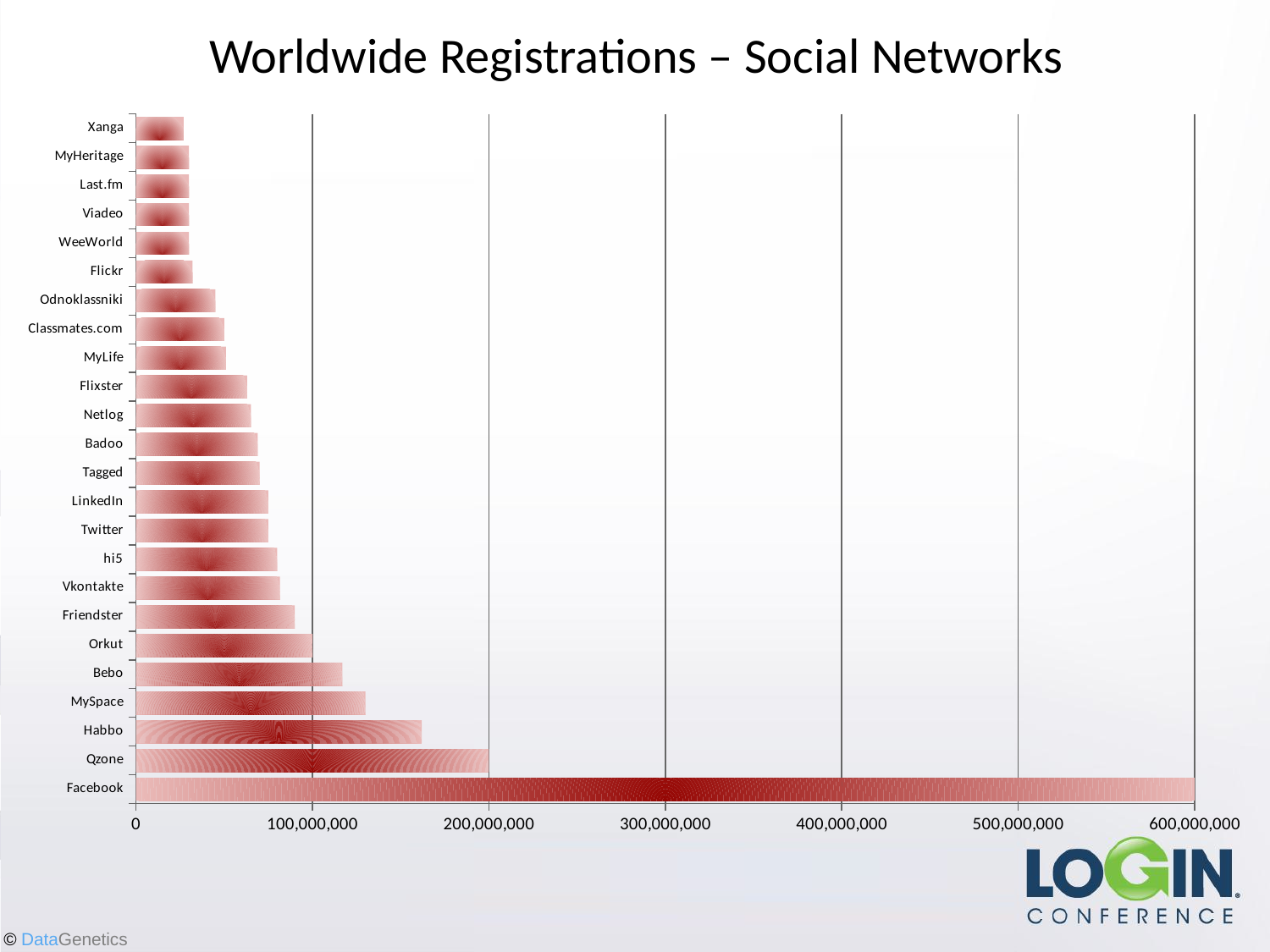
What is the value for Qzone? 200,000,000 Which social network has the highest number of worldwide registrations? Facebook How many social networks are plotted in the chart? 24 What kind of chart is shown on the slide? bar chart What is the title of the chart? Worldwide Registrations – Social Networks Is the value for Habbo greater or less than 100,000,000? greater Is the value for MySpace greater or less than 200,000,000? less Is the value for Xanga greater or less than 100,000,000? less Which has more registrations, Xanga or Friendster? Friendster What is the value for Facebook? 600,000,000 Which has more registrations, Habbo or MySpace? Habbo